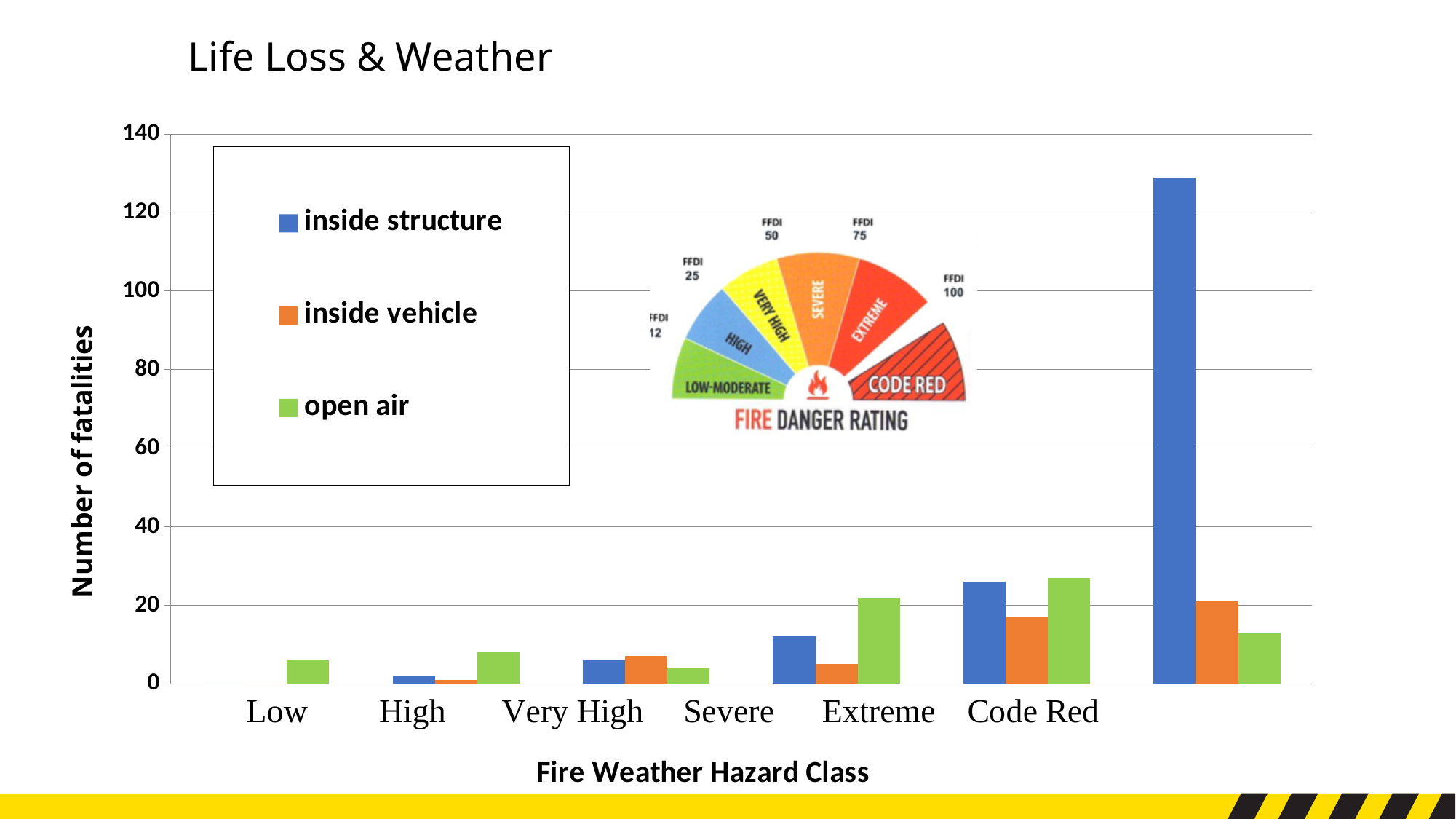
What is the label of the vertical axis? Number of fatalities How many fire weather hazard classes are shown on the x axis? 6 At Severe, which is larger: open air or inside vehicle? open air What is the title of the chart? Life Loss & Weather Is the value for open air at Extreme greater or less than 20? greater How many series does the legend list? 3 What kind of chart is shown on the slide? bar chart Is the value for inside structure at Code Red greater or less than 120? greater Is the value for open air at Code Red greater or less than 20? less At Code Red, which is larger: inside structure or inside vehicle? inside structure Which series has the tallest bar on the chart? inside structure Which hazard class has the highest number of fatalities inside structure? Code Red